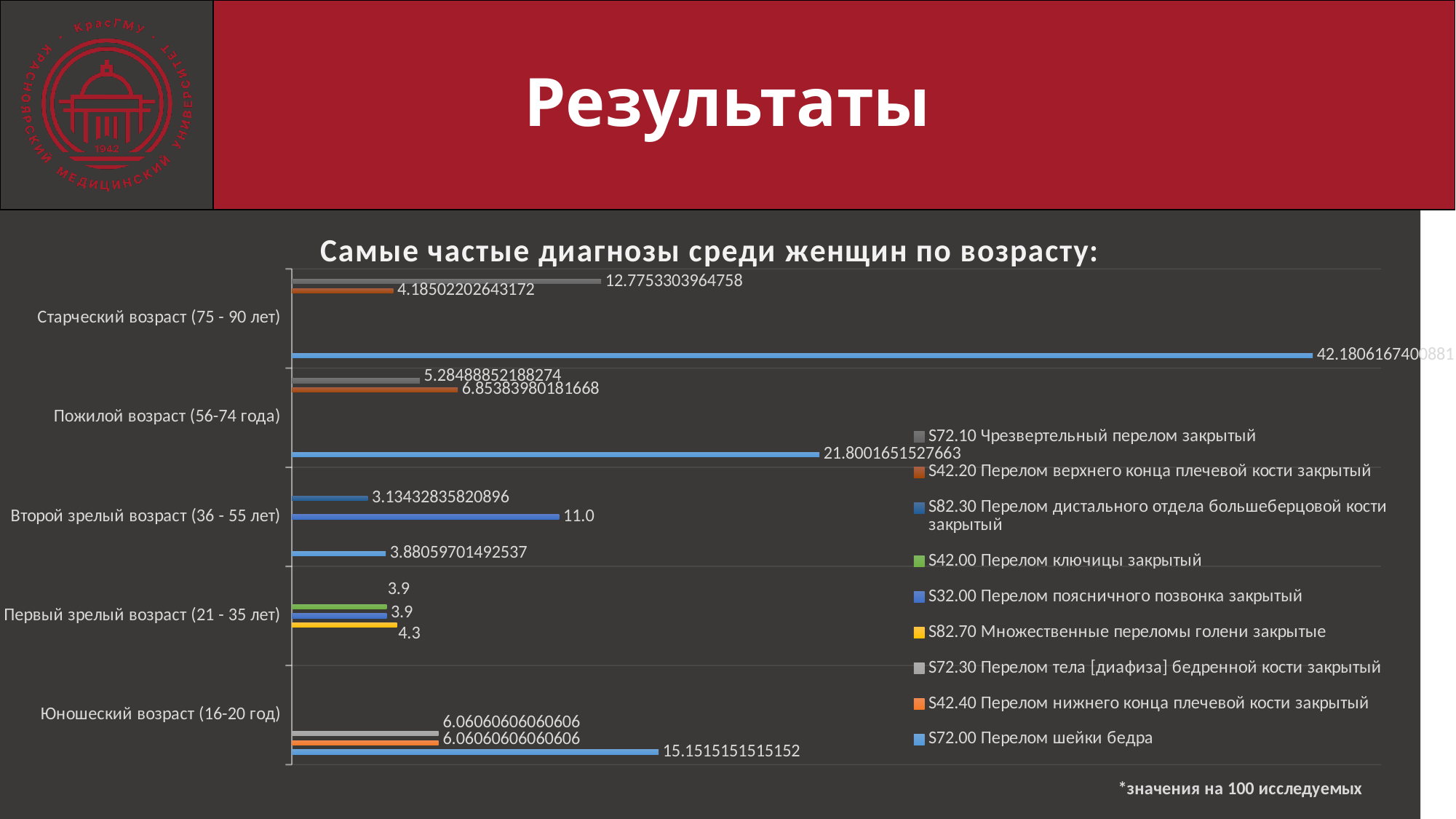
How many series does the legend list? 9 What is the value of the orange bar for Старческий возраст (75 - 90 лет)? 4.18502202643172 What is the highest value shown for Юношеский возраст (16-20 год)? 15.1515151515152 What is the title of the chart? Самые частые диагнозы среди женщин по возрасту: What is the highest value shown for Старческий возраст (75 - 90 лет)? 42.1806167400881 What kind of chart is shown on the slide? bar chart Which age group has the single highest value on the chart? Старческий возраст (75 - 90 лет) What is the highest value shown for Пожилой возраст (56-74 года)? 21.8001651527663 How many age groups are shown on the chart's vertical axis? 5 What is the difference between the highest value for Старческий возраст (75 - 90 лет) and the highest value for Пожилой возраст (56-74 года)? 20.3804515873218 What is the value of the yellow bar (S82.70) for Первый зрелый возраст (21 - 35 лет)? 4.3 Which is larger: the highest value for Юношеский возраст (16-20 год) or the highest value for Пожилой возраст (56-74 года)? Пожилой возраст (56-74 года)